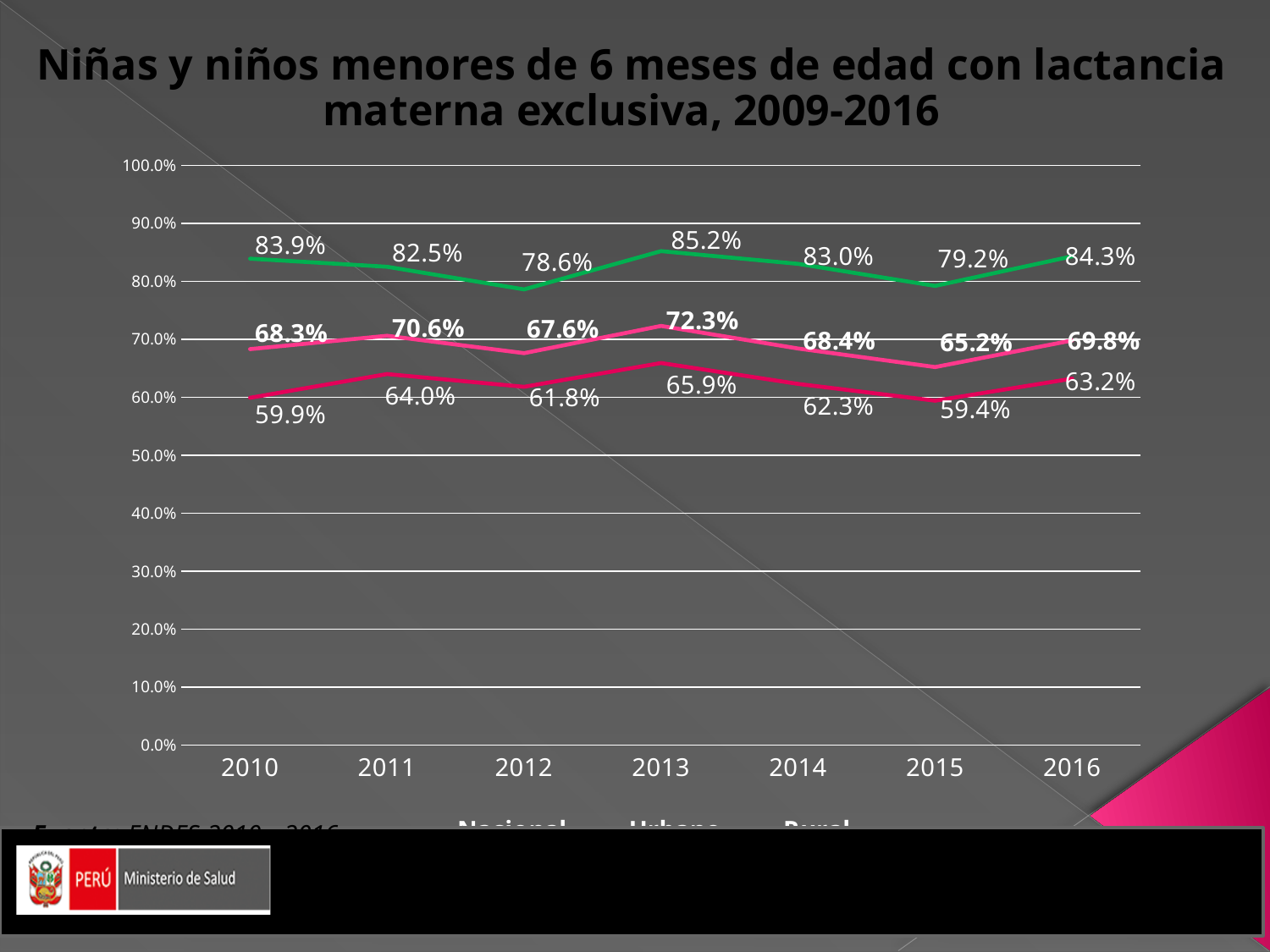
By how many percentage points did the top (green) line increase from 2015 to 2016? 5.1 Does the middle line (bold labels) rise or fall from 2013 to 2015? Fall How many years are plotted along the x axis of the chart? 7 In which year does the top (green) line reach its lowest value? 2012 What is the title of the chart? Niñas y niños menores de 6 meses de edad con lactancia materna exclusiva, 2009-2016 What type of chart is shown on the slide? Line chart In which year does the top (green) line reach its highest value? 2013 What is the value of the top (green) line in 2013? 85.2% What is the value of the middle line (bold labels) in 2016? 69.8% In which year does the middle line (bold labels) reach its highest value? 2013 For the bottom line, which year has the larger value, 2011 or 2012? 2011 In which year does the bottom line reach its lowest value? 2015